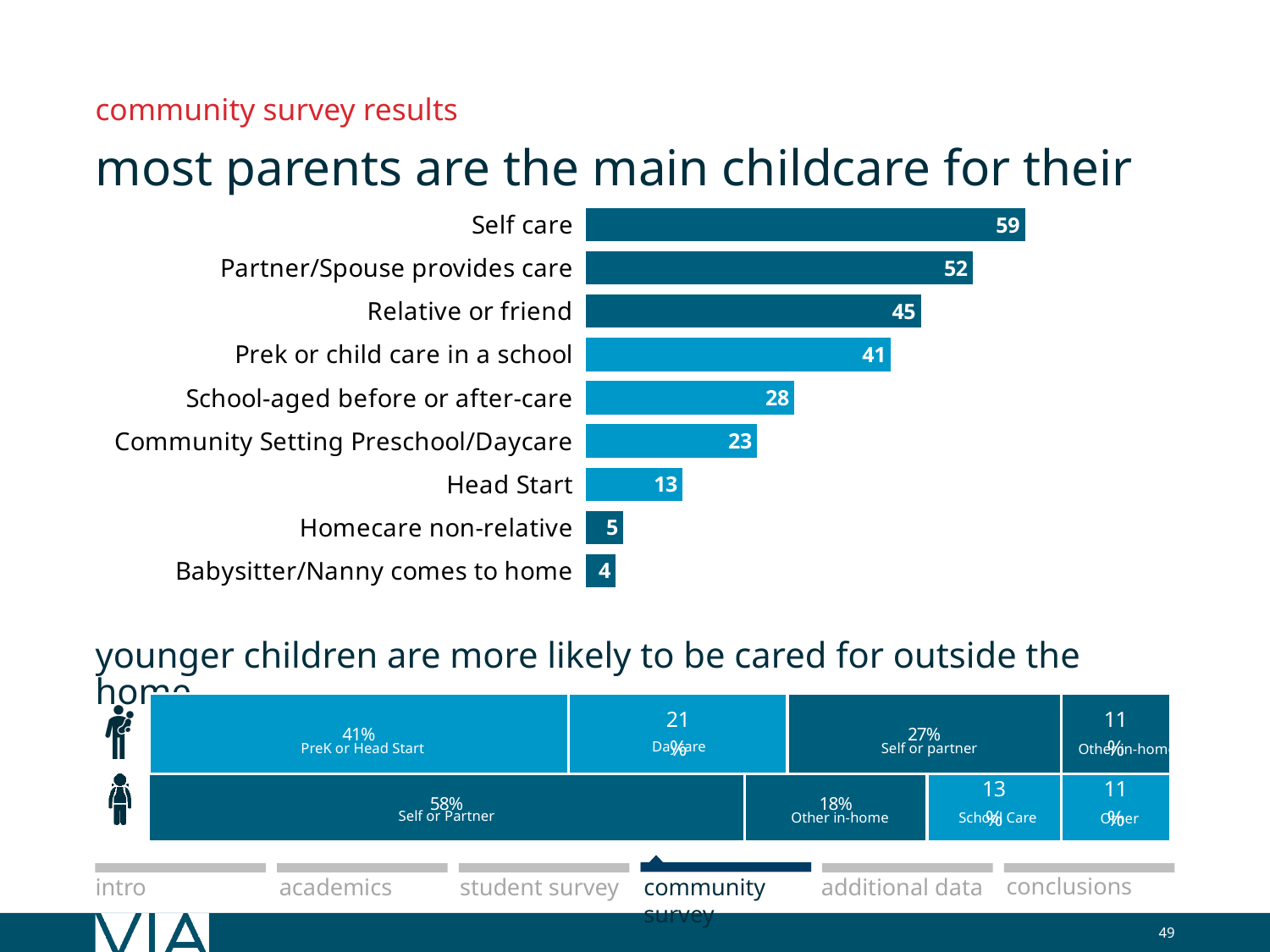
In the top bar chart, which category has the lowest value? Babysitter/Nanny comes to home In the top bar chart, what is the difference between Self care and Partner/Spouse provides care? 7 In the top bar chart, what is the difference between Prek or child care in a school and School-aged before or after-care? 13 In the bottom stacked bar chart, what percentage is shown for Self or Partner in the lower bar? 58% In the top bar chart, what is the value for Head Start? 13 In the top bar chart, what is the value for Relative or friend? 45 How many categories are shown in the top bar chart? 9 In the top bar chart, what is the value for Self care? 59 In the top bar chart, which is larger: Homecare non-relative or Head Start? Head Start In the top bar chart, what is the value for Community Setting Preschool/Daycare? 23 In the top bar chart, which category has the highest value? Self care What type of chart is the top chart on the slide? Bar chart